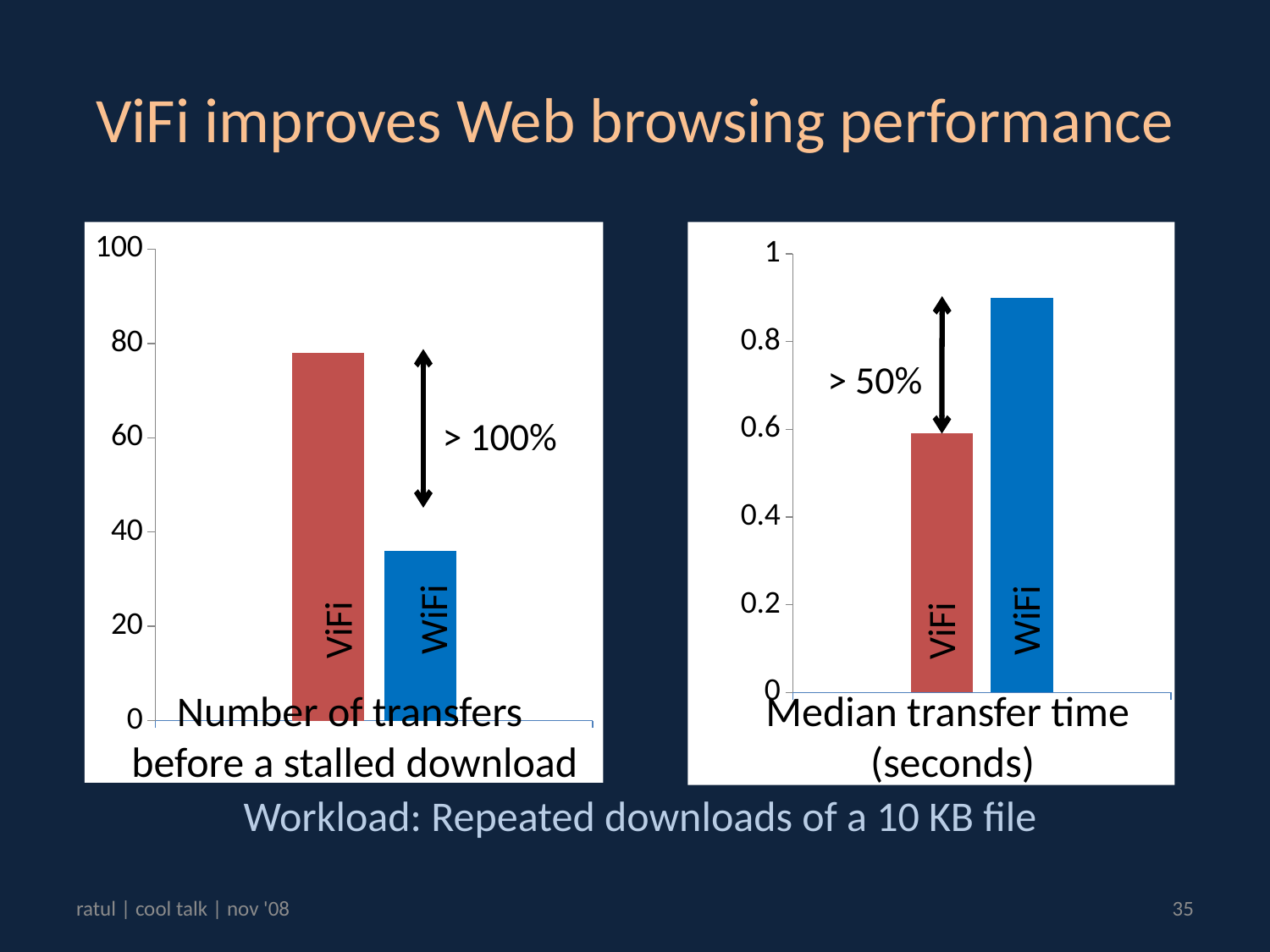
In the left chart, 'Number of transfers before a stalled download', is the value for WiFi greater or less than 40? less What percentage improvement is annotated between the bars in the right chart, 'Median transfer time (seconds)'? > 50% In the right chart, 'Median transfer time (seconds)', which bar is higher, ViFi or WiFi? WiFi What is the highest value shown on the vertical axis of the left chart, 'Number of transfers before a stalled download'? 100 How many bars are plotted in the left chart, 'Number of transfers before a stalled download'? 2 In the right chart, 'Median transfer time (seconds)', is the value for WiFi greater or less than 0.8? greater In the right chart, 'Median transfer time (seconds)', which bar is lower, ViFi or WiFi? ViFi In the left chart, 'Number of transfers before a stalled download', is the value for ViFi greater or less than 60? greater What kind of chart is the left chart, 'Number of transfers before a stalled download'? bar chart In the left chart, 'Number of transfers before a stalled download', which bar is higher, ViFi or WiFi? ViFi